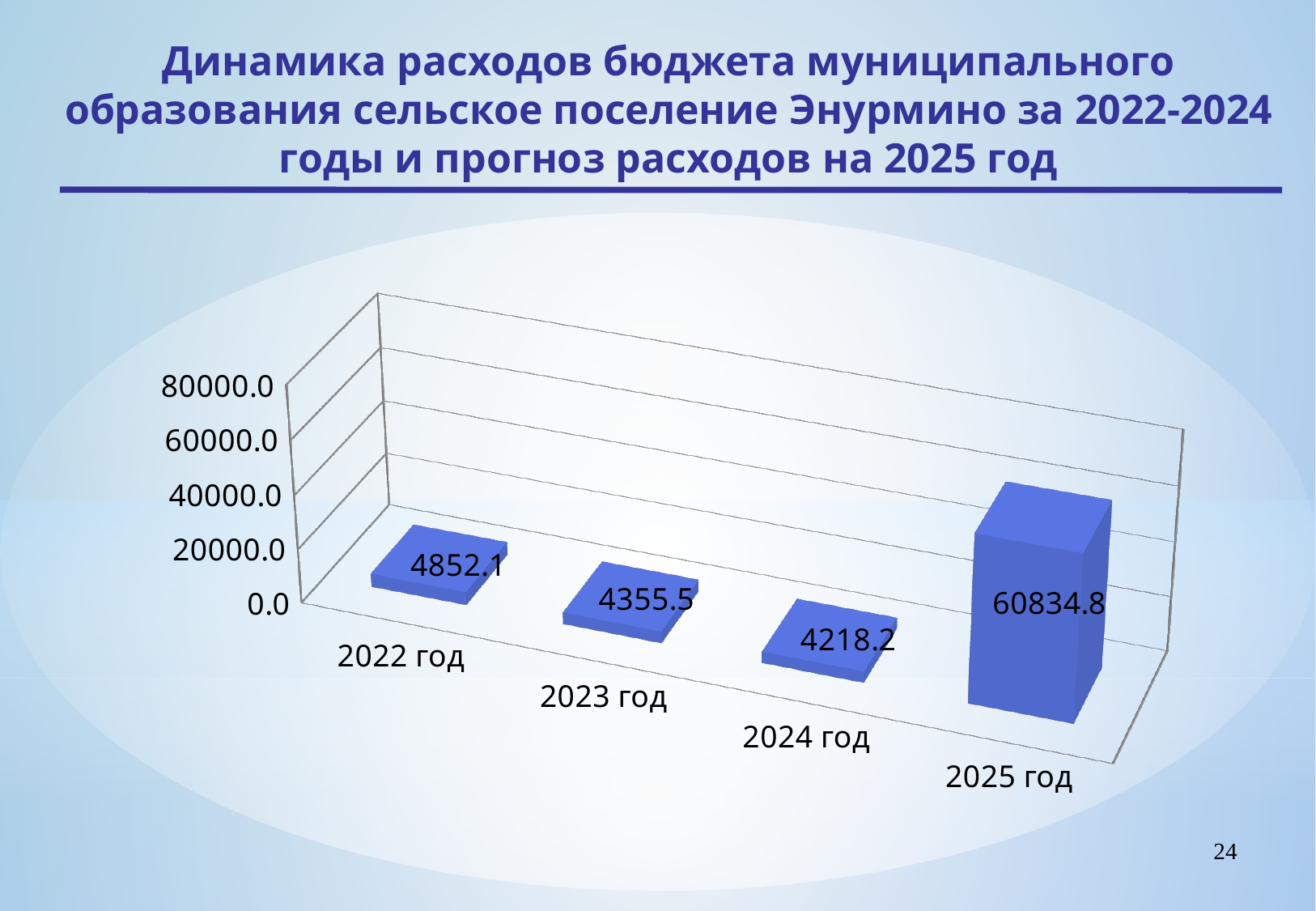
What is the difference between the values for 2022 год and 2023 год? 496.6 Do the values rise or fall from 2022 год to 2024 год? fall Which year has the lowest value? 2024 год Which is larger, the value for 2023 год or the value for 2024 год? 2023 год How many years are shown on the chart? 4 What is the value shown for 2024 год? 4218.2 Is the value for 2025 год greater or less than 40000? greater What is the difference between the values for 2025 год and 2022 год? 55982.7 What is the value shown for 2022 год? 4852.1 What is the forecast value shown for 2025 год? 60834.8 Which year has the highest value? 2025 год What kind of chart is shown on the slide? bar chart